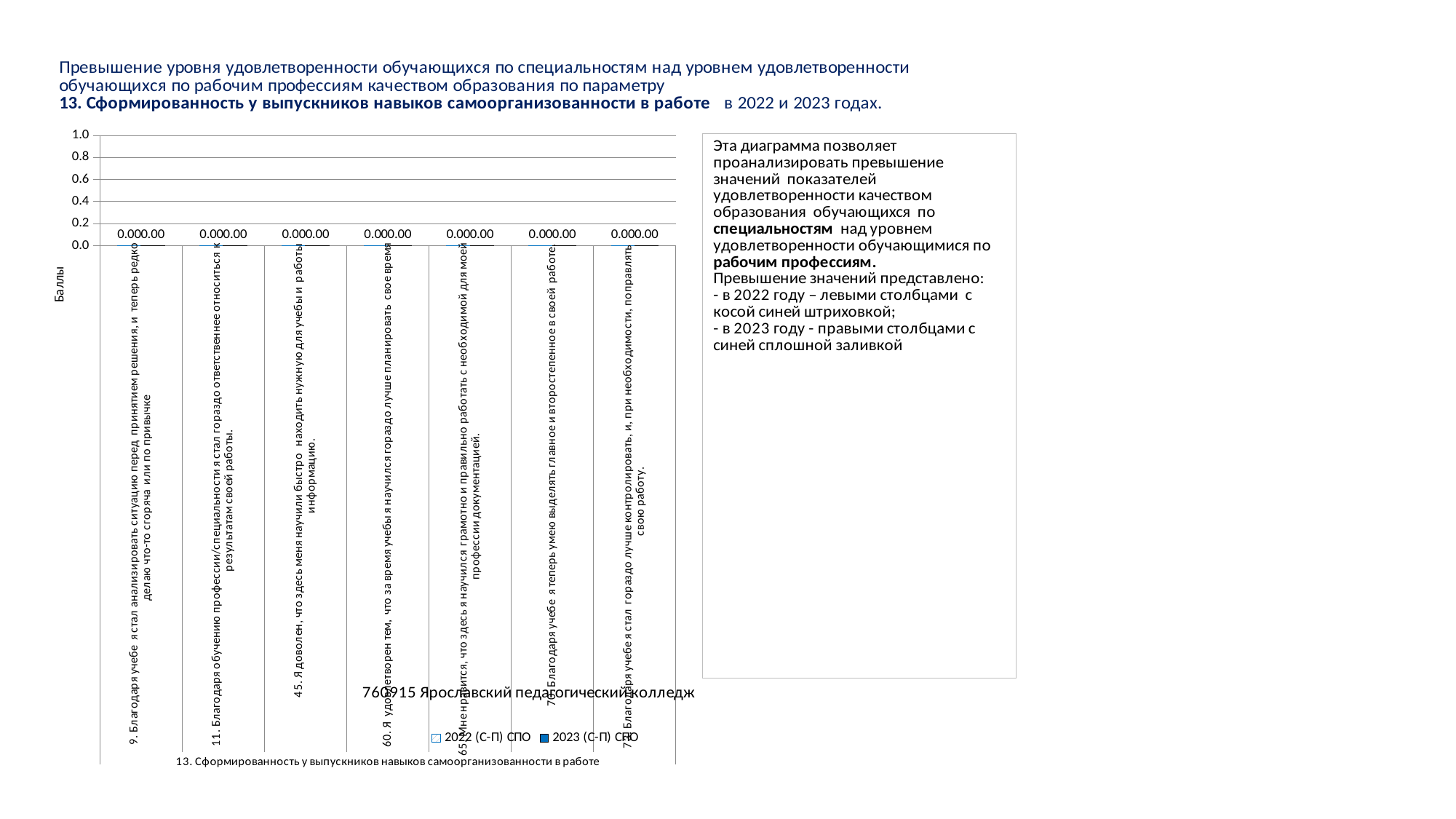
What is the step between consecutive tick marks on the vertical axis of the chart? 0.2 What data label is printed above the category '45. Я доволен, что здесь меня научили быстро находить нужную для учебы и работы информацию.'? 0.00 What is the highest tick value shown on the vertical axis of the chart? 1.0 What kind of chart is shown on the slide? bar chart What is the label of the vertical axis of the chart? Баллы How many categories are shown along the x axis of the chart? 7 How many series does the chart legend list? 2 What are the two series named in the chart legend? 2022 (С-П) СПО and 2023 (С-П) СПО What data label is printed above the category '9. Благодаря учебе я стал анализировать ситуацию перед принятием решения...'? 0.00